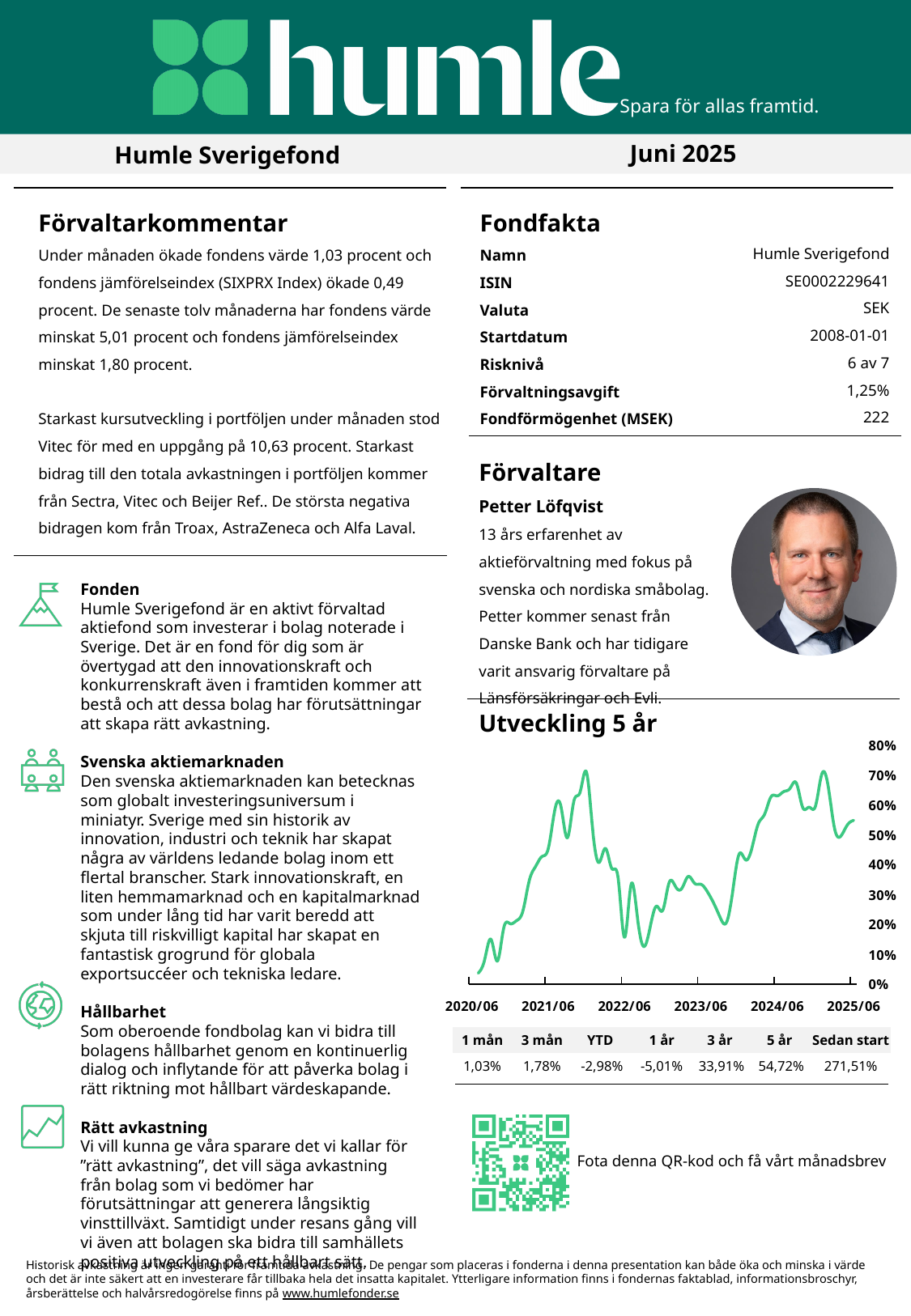
In the "Utveckling 5 år" chart, which is higher: the value at 2021/06 or the value at 2020/06? 2021/06 How many lines are plotted in the "Utveckling 5 år" chart? 1 Overall, does the line in the "Utveckling 5 år" chart rise or fall from 2020/06 to 2025/06? rise What kind of chart is shown under the heading "Utveckling 5 år"? line chart In the "Utveckling 5 år" chart, is the value at 2025/06 greater or less than 40%? greater What is the highest value shown on the y axis of the "Utveckling 5 år" chart? 80% In the "Utveckling 5 år" chart, is the value at 2023/06 greater or less than 50%? less What is the first date label on the x axis of the "Utveckling 5 år" chart? 2020/06 In the "Utveckling 5 år" chart, is the value at 2020/06 greater or less than 10%? less How many date labels are shown on the x axis of the "Utveckling 5 år" chart? 6 What is the title of the chart on the slide? Utveckling 5 år